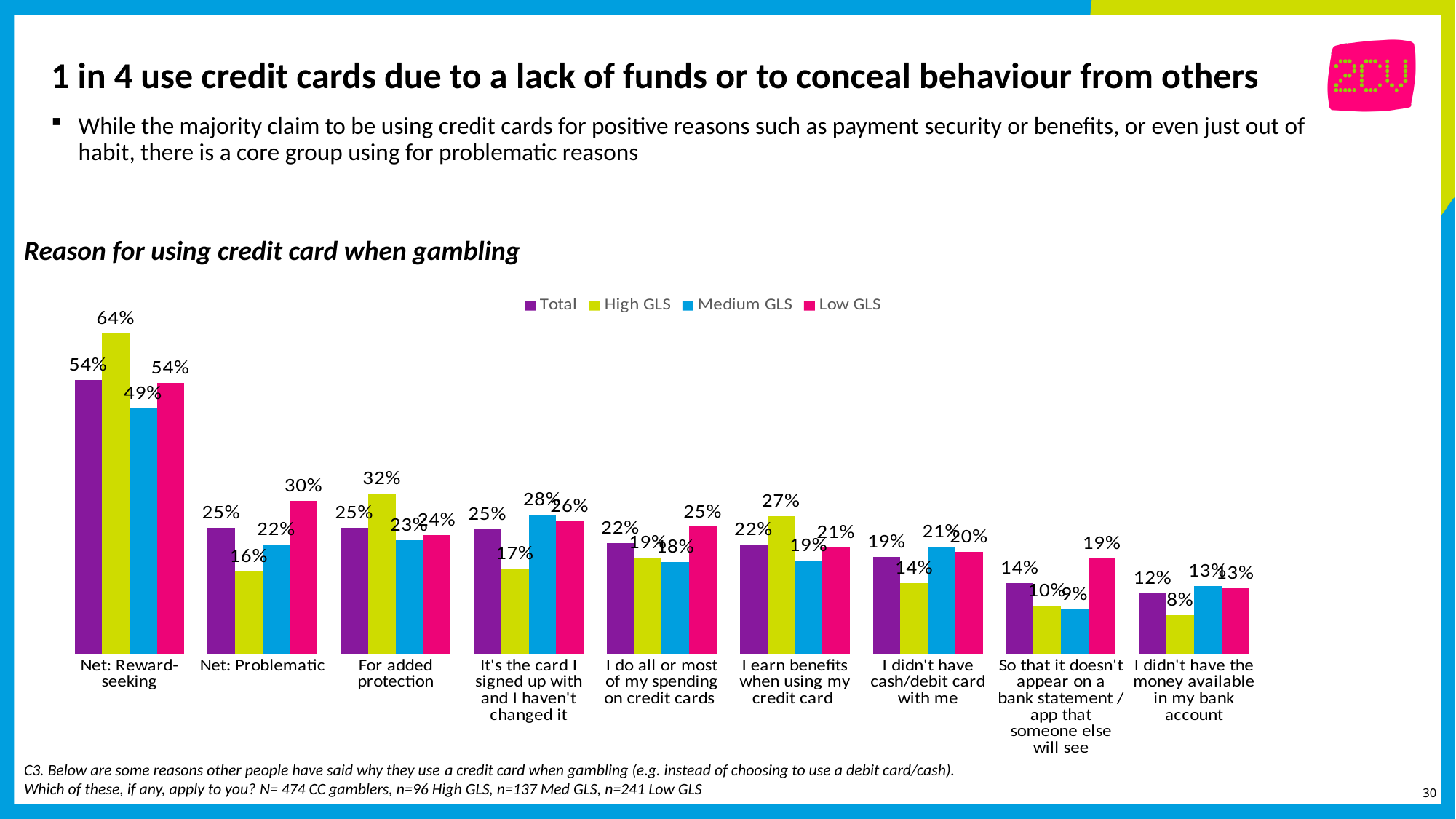
What is the difference between the Low GLS and High GLS values for Net: Problematic? 14% How many series does the legend list? 4 What is the Medium GLS value for 'It's the card I signed up with and I haven't changed it'? 28% What is the Low GLS value for 'So that it doesn't appear on a bank statement / app that someone else will see'? 19% What is the Total value for Net: Reward-seeking? 54% Which group has the highest value for Net: Reward-seeking? High GLS What kind of chart is shown on the slide? Bar chart Which is larger for 'For added protection': the High GLS value or the Medium GLS value? High GLS What is the title of the chart? Reason for using credit card when gambling Which group has the lowest value for 'I didn't have the money available in my bank account'? High GLS How many reason categories are shown on the x axis? 9 What is the High GLS value for Net: Problematic? 16%